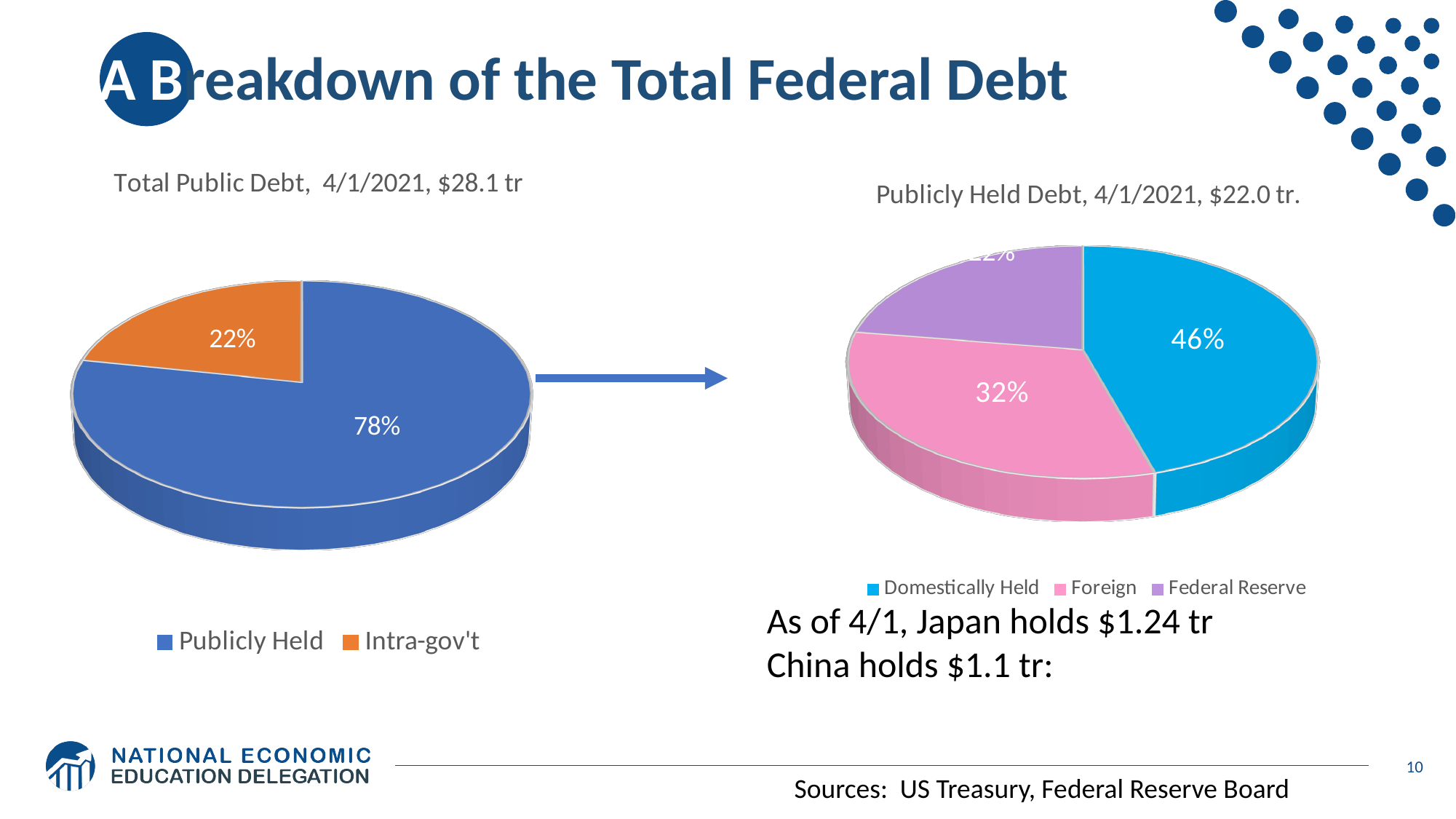
In the Publicly Held Debt chart, which category has the largest share? Domestically Held In the Publicly Held Debt chart, which category has the smallest share? Federal Reserve In the Publicly Held Debt chart, which is larger, the Foreign share or the Domestically Held share? Domestically Held In the Total Public Debt chart, what share of the debt is Intra-gov't? 22% In the Publicly Held Debt chart, what share is Domestically Held? 46% In the Publicly Held Debt chart, what is the difference in percentage points between the Domestically Held and Foreign shares? 14 percentage points What type of chart is the Total Public Debt chart? Pie chart In the Publicly Held Debt chart, what share is Foreign? 32% In the Total Public Debt chart, what is the difference in percentage points between the Publicly Held and Intra-gov't shares? 56 percentage points In the Total Public Debt chart, what share of the debt is Publicly Held? 78% How many categories does the legend of the Publicly Held Debt chart list? 3 What total dollar amount is given in the title of the Publicly Held Debt chart? $22.0 tr.